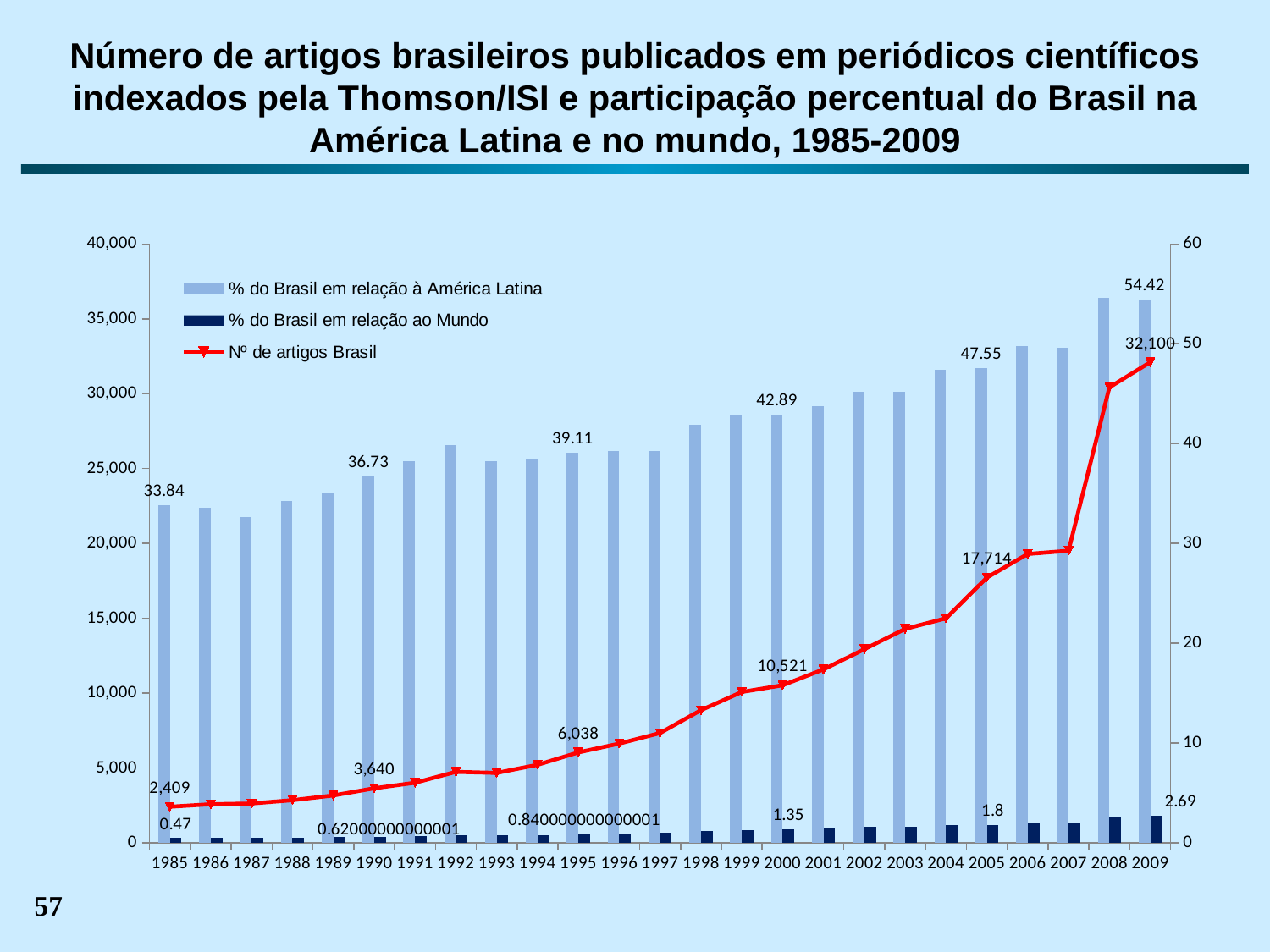
How many series does the legend list? 3 What kind of chart is this? Combined bar and line chart What is the value of "% do Brasil em relação ao Mundo" in 2005? 1.8 What is the difference between the "% do Brasil em relação à América Latina" values in 2009 and 1985? 20.58 What is the value of "% do Brasil em relação à América Latina" in 2000? 42.89 What is the value of "Nº de artigos Brasil" in 2009? 32,100 Does the "Nº de artigos Brasil" line rise or fall from 1985 to 2009? Rises Is the "Nº de artigos Brasil" value in 2007 greater or less than 20,000? less What is the difference between the number of Brazilian articles in 2005 and in 2000? 7,193 What is the value of "Nº de artigos Brasil" in 1985? 2,409 How many years are shown on the x axis? 25